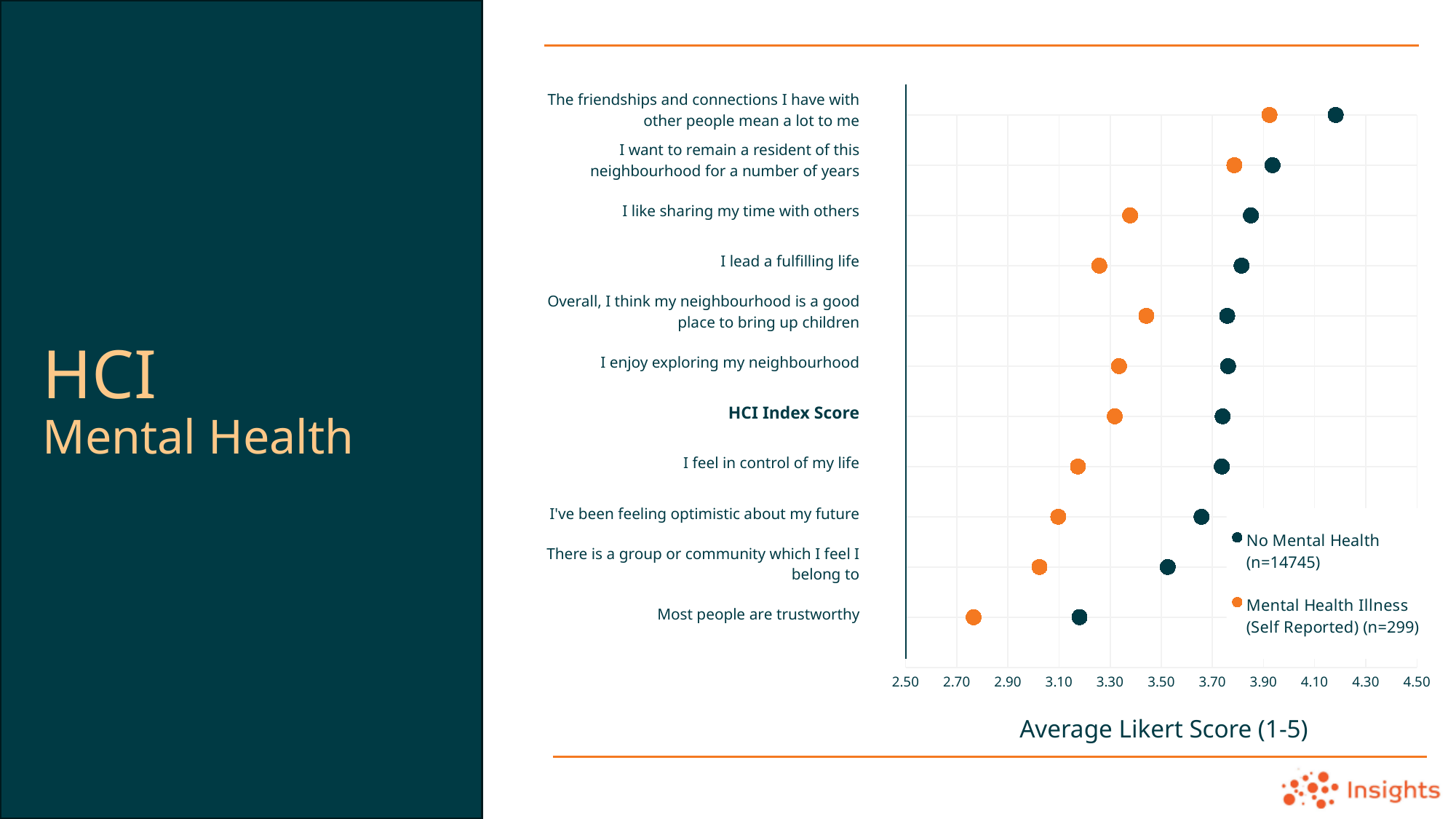
Is the No Mental Health value for 'The friendships and connections I have with other people mean a lot to me' greater or less than 4.10? greater For the HCI Index Score, which group has the higher value: No Mental Health or Mental Health Illness (Self Reported)? No Mental Health How many statements (categories) are plotted on the chart? 11 Which statement has the lowest score for the No Mental Health group? Most people are trustworthy Is the No Mental Health value for 'I like sharing my time with others' greater or less than 3.70? greater What kind of chart is shown on the slide? Dot plot (scatter chart) What is the title of the horizontal axis? Average Likert Score (1-5) Which statement has the lowest score for the Mental Health Illness (Self Reported) group? Most people are trustworthy Which statement has the highest score for the No Mental Health group? The friendships and connections I have with other people mean a lot to me Is the Mental Health Illness (Self Reported) value for 'Most people are trustworthy' greater or less than 2.90? less How many series does the legend list? 2